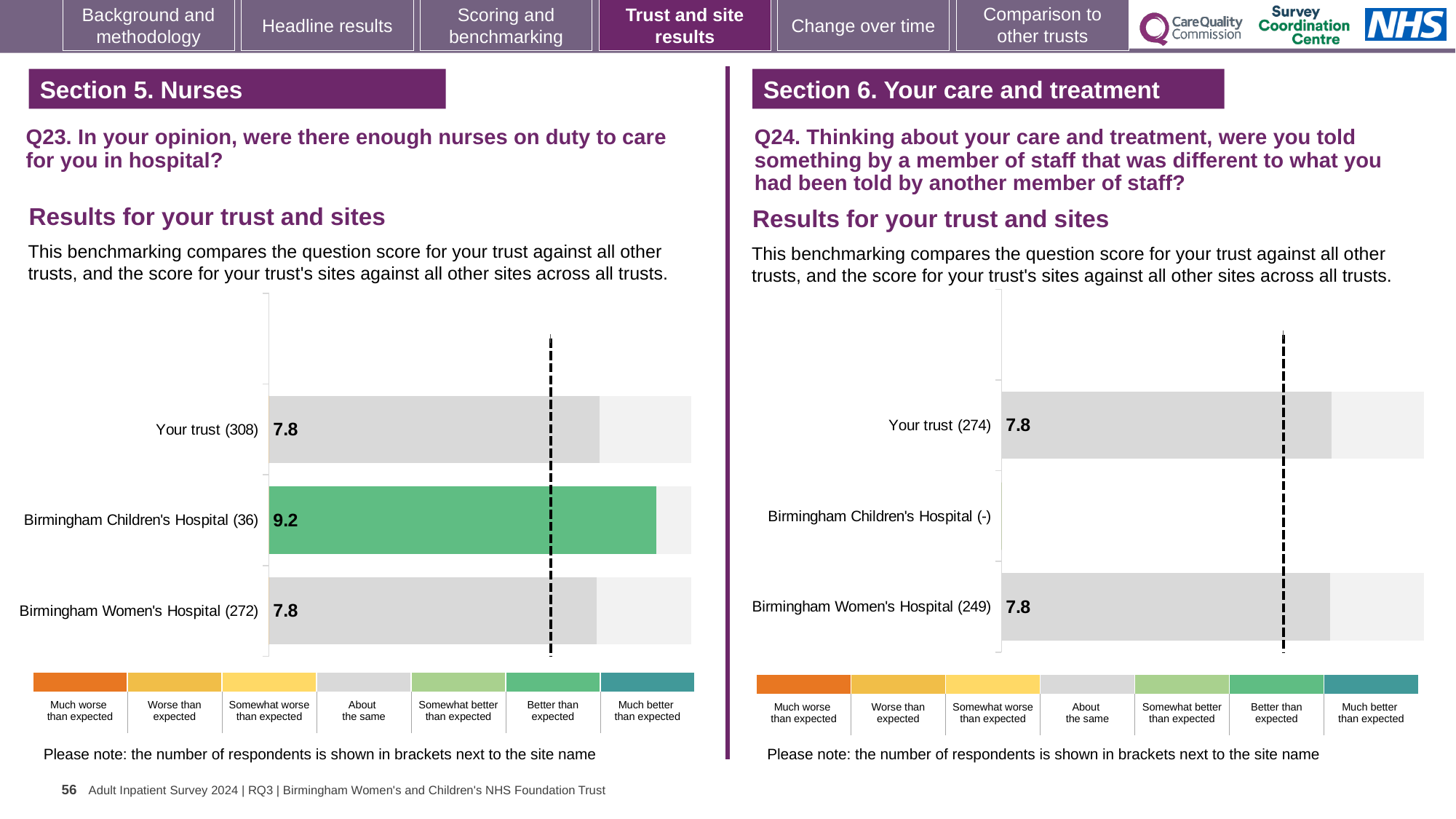
In the Q23 chart on the left, what is the score for Birmingham Children's Hospital? 9.2 In the Q24 chart on the right, what is the score for Your trust? 7.8 In the Q24 chart on the right, what is the score for Birmingham Women's Hospital? 7.8 How many categories (rows) are shown in the Q24 chart on the right? 3 In the Q23 chart on the left, what is the difference between the score for Birmingham Children's Hospital and the score for Your trust? 1.4 In the Q23 chart on the left, which site has the highest score? Birmingham Children's Hospital In the Q23 chart on the left, what is the score for Birmingham Women's Hospital? 7.8 In the Q23 chart on the left, how many respondents are shown in brackets for Birmingham Children's Hospital? 36 In the Q23 chart on the left, which has the larger score, Birmingham Children's Hospital or Birmingham Women's Hospital? Birmingham Children's Hospital In the Q24 chart on the right, how many respondents are shown in brackets for Your trust? 274 What kind of chart is the Q23 chart on the left? Bar chart In the Q23 chart on the left, what is the score for Your trust? 7.8